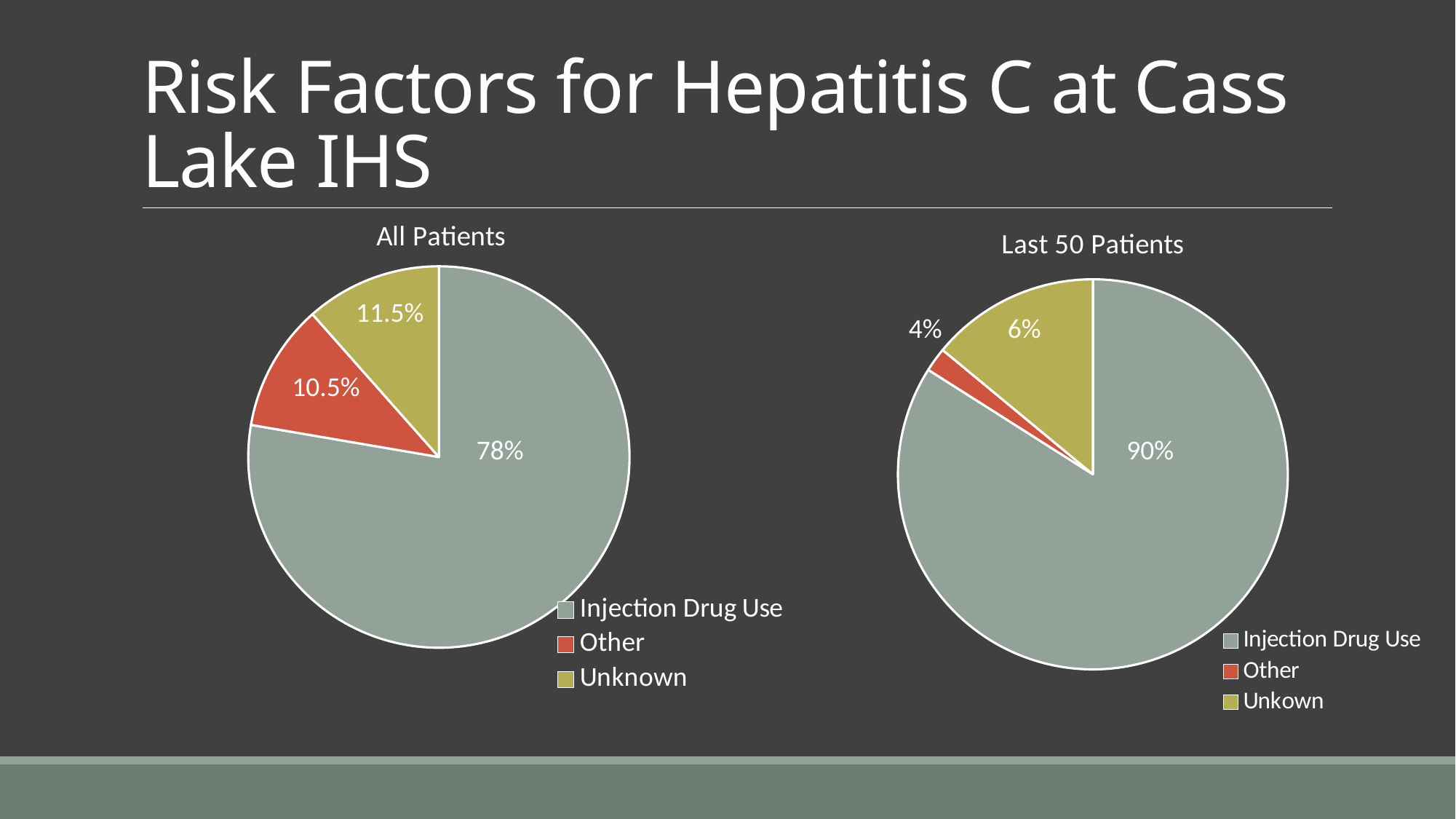
How many slices does the 'Last 50 Patients' chart have? 3 In the 'All Patients' chart, what is the value for Other? 10.5% In the 'Last 50 Patients' chart, what is the value for Unkown? 6% In the 'Last 50 Patients' chart, what is the value for Other? 4% In the 'All Patients' chart, what is the difference between the Unknown and Other slices? 1% In the 'All Patients' chart, what is the value for Unknown? 11.5% In the 'Last 50 Patients' chart, which is larger, Other or Unkown? Unkown In the 'All Patients' chart, which category has the largest slice? Injection Drug Use What type of chart is the 'All Patients' chart? Pie chart In the 'Last 50 Patients' chart, which category has the smallest slice? Other In the 'Last 50 Patients' chart, what share of the pie is Injection Drug Use? 90% In the 'All Patients' chart, what share of the pie is Injection Drug Use? 78%